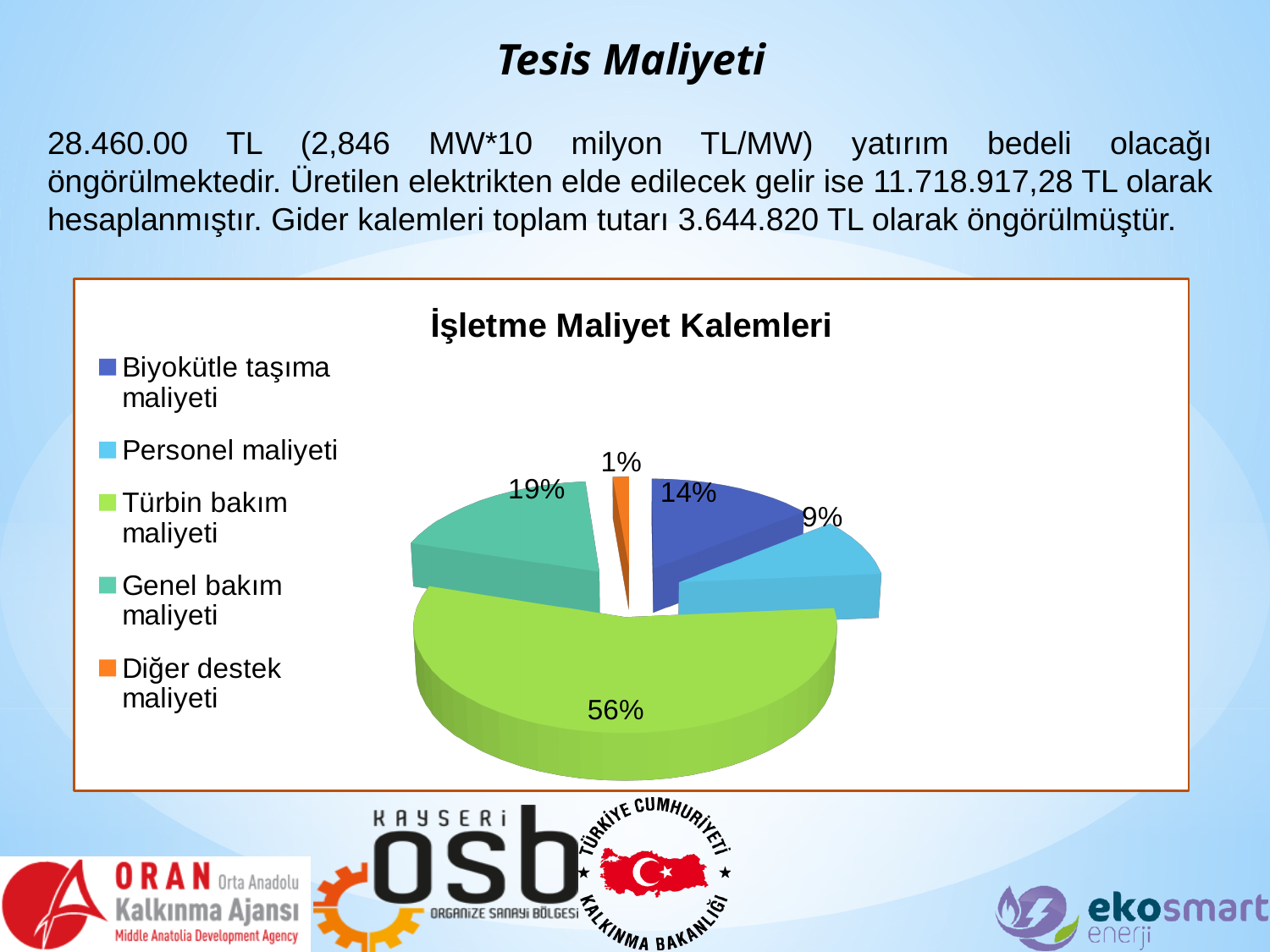
What is the difference in percentage points between Genel bakım maliyeti and Personel maliyeti? 10 What share of the pie is Türbin bakım maliyeti? 56% What is the chart's title? İşletme Maliyet Kalemleri What kind of chart is shown on the slide? pie chart What share of the pie is Biyokütle taşıma maliyeti? 14% Which cost item has the smallest share of the pie? Diğer destek maliyeti What share of the pie is Diğer destek maliyeti? 1% How many categories does the pie chart show? 5 Which is larger, Biyokütle taşıma maliyeti or Personel maliyeti? Biyokütle taşıma maliyeti Which cost item has the largest share of the pie? Türbin bakım maliyeti